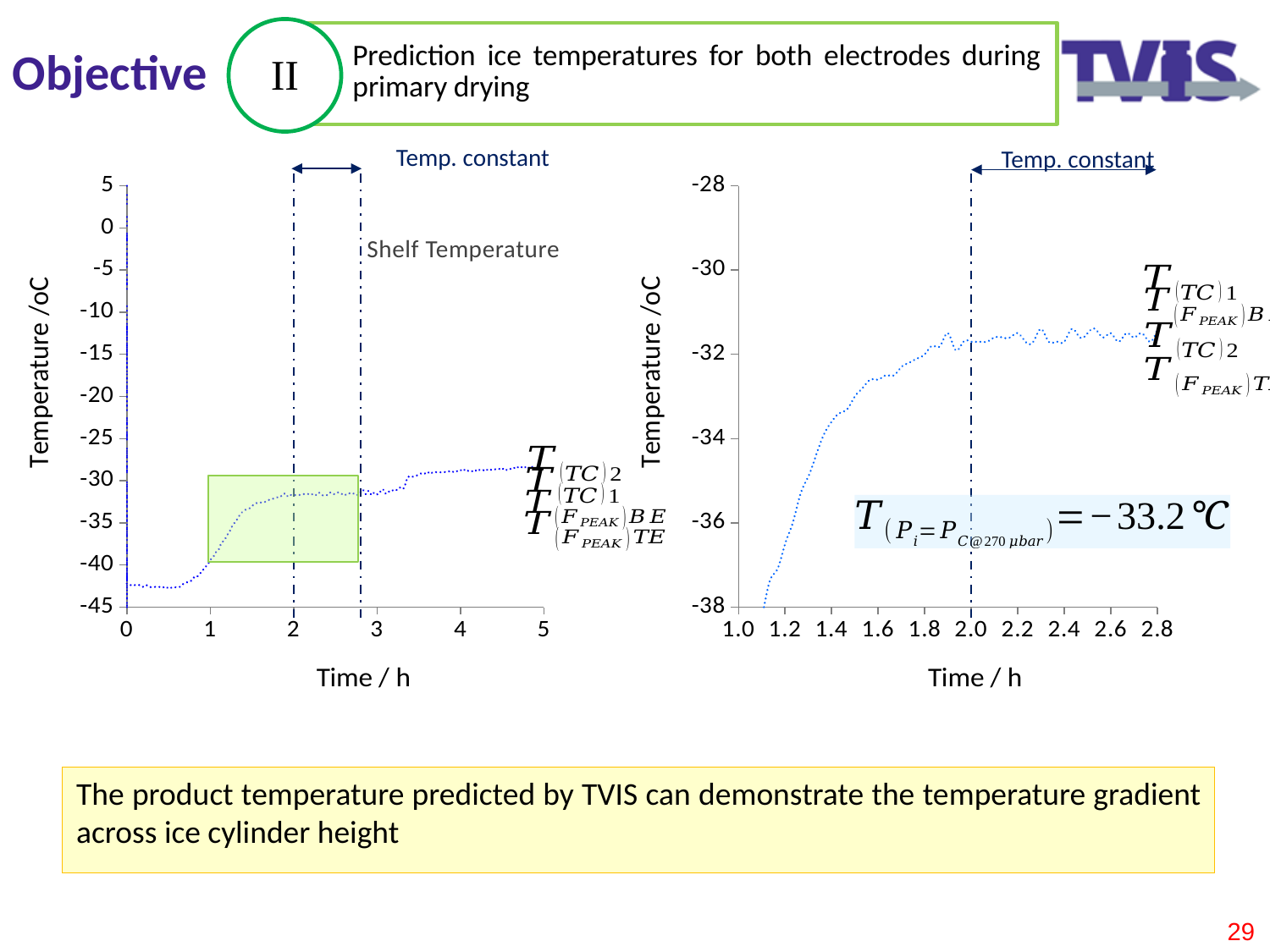
On the left chart, is the temperature at time 2 h greater or less than -30? less On the left chart, is the temperature at time 2 h greater or less than -35? greater What kind of chart is the left chart on the slide? line chart On the right chart, is the temperature at time 2.0 h greater or less than -30? less What is the x-axis label of the left chart? Time / h What kind of chart is the right chart on the slide? line chart What is the y-axis label of the right chart? Temperature /oC On the right chart, does the plotted temperature rise or fall overall as time increases from 1.0 to 2.8 h? rise On the left chart, does the plotted temperature rise or fall overall as time increases from 0 to 5 h? rise